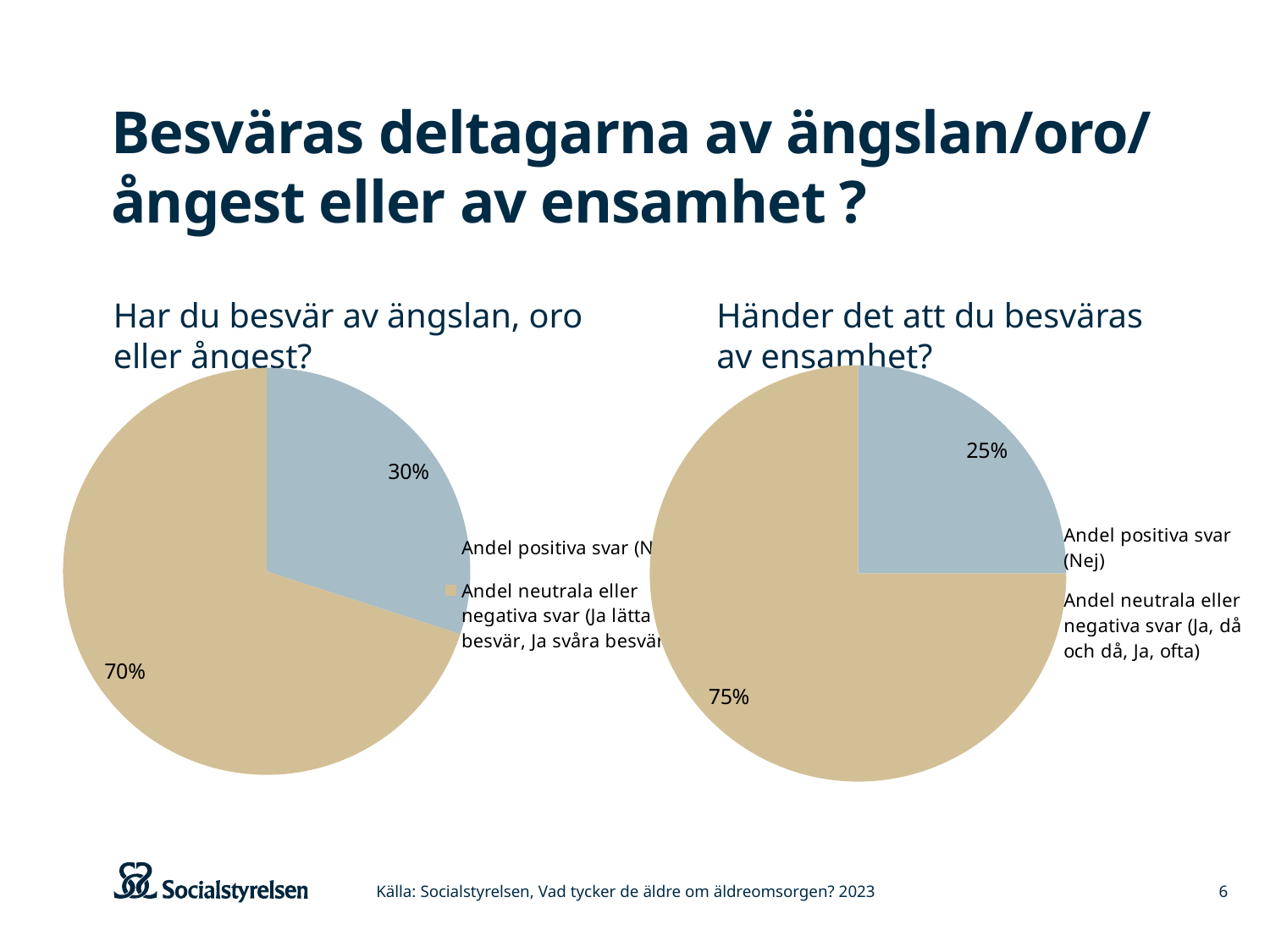
In the right chart 'Händer det att du besväras av ensamhet?', which slice is the smallest? Andel positiva svar (Nej) In the left chart 'Har du besvär av ängslan, oro eller ångest?', what is the difference between the neutral/negative share and the positive share? 40 percentage points Is the positive (Nej) share larger in the left chart 'Har du besvär av ängslan, oro eller ångest?' or in the right chart 'Händer det att du besväras av ensamhet?'? The left chart How many charts are shown on the slide? 2 In the left chart 'Har du besvär av ängslan, oro eller ångest?', what share of answers are positive (Nej)? 30% How many slices does the right chart 'Händer det att du besväras av ensamhet?' have? 2 In the right chart 'Händer det att du besväras av ensamhet?', what share of answers are positive (Nej)? 25% What kind of chart is used on this slide? Pie chart In the left chart 'Har du besvär av ängslan, oro eller ångest?', which slice is the largest? Andel neutrala eller negativa svar In the right chart 'Händer det att du besväras av ensamhet?', what share of answers are neutral or negative? 75% In the left chart 'Har du besvär av ängslan, oro eller ångest?', what share of answers are neutral or negative? 70% In the right chart 'Händer det att du besväras av ensamhet?', what is the difference between the neutral/negative share and the positive share? 50 percentage points